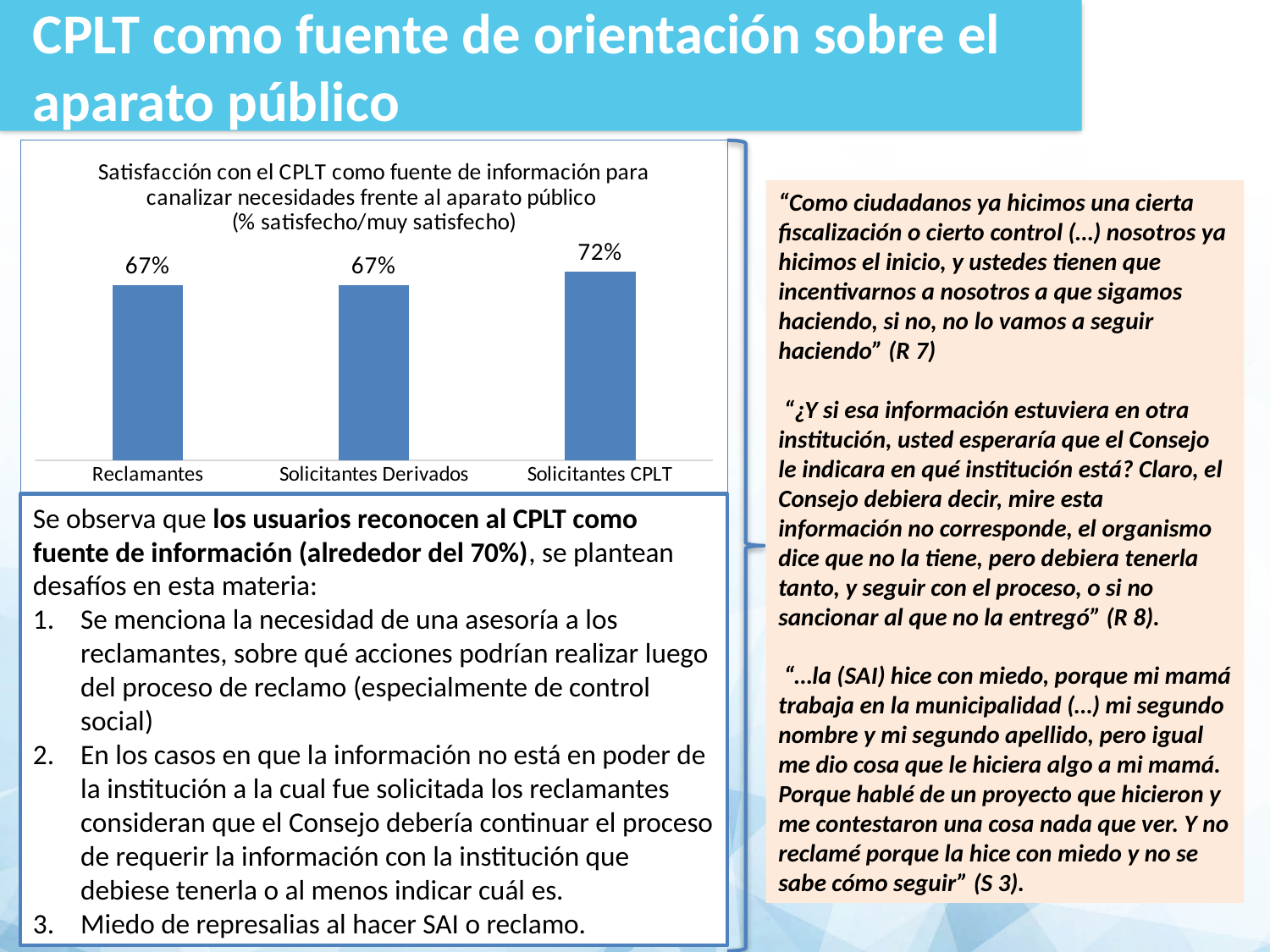
What is the title of the chart? Satisfacción con el CPLT como fuente de información para canalizar necesidades frente al aparato público (% satisfecho/muy satisfecho) How many categories are shown in the chart? 3 Do the values for Reclamantes and Solicitantes Derivados differ? No, both are 67% What is the value for Reclamantes? 67% Which is larger, the value for Solicitantes CPLT or the value for Solicitantes Derivados? Solicitantes CPLT Which category has the highest value? Solicitantes CPLT What colour are the bars in the chart? Blue What kind of chart is shown on the slide? Bar chart What is the value for Solicitantes CPLT? 72% What is the difference between the values for Solicitantes CPLT and Reclamantes? 5% What is the value for Solicitantes Derivados? 67%